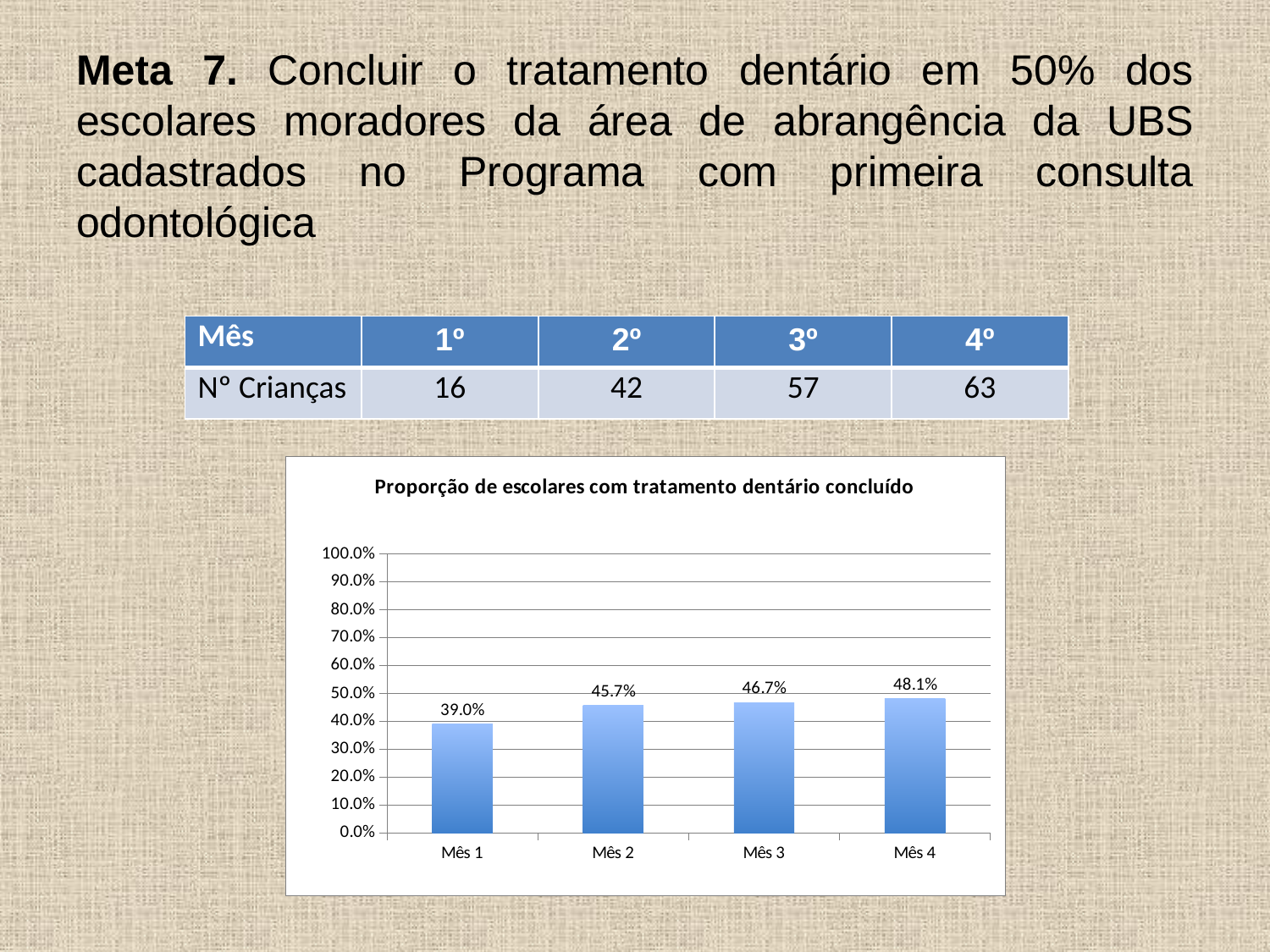
Is the value for Mês 4 greater or less than 50.0%? less What is the difference between the values for Mês 2 and Mês 1? 6.7% What is the value for Mês 1 in the chart? 39.0% What is the difference between the values for Mês 4 and Mês 3? 1.4% What kind of chart is shown on the slide? bar chart What is the value for Mês 3 in the chart? 46.7% Which month has the highest proportion in the chart? Mês 4 Which month has the lowest proportion in the chart? Mês 1 Do the values rise or fall from Mês 1 to Mês 4? rise What is the value for Mês 4 in the chart? 48.1% How many months are shown on the x axis of the chart? 4 Which is larger, the value for Mês 2 or the value for Mês 1? Mês 2